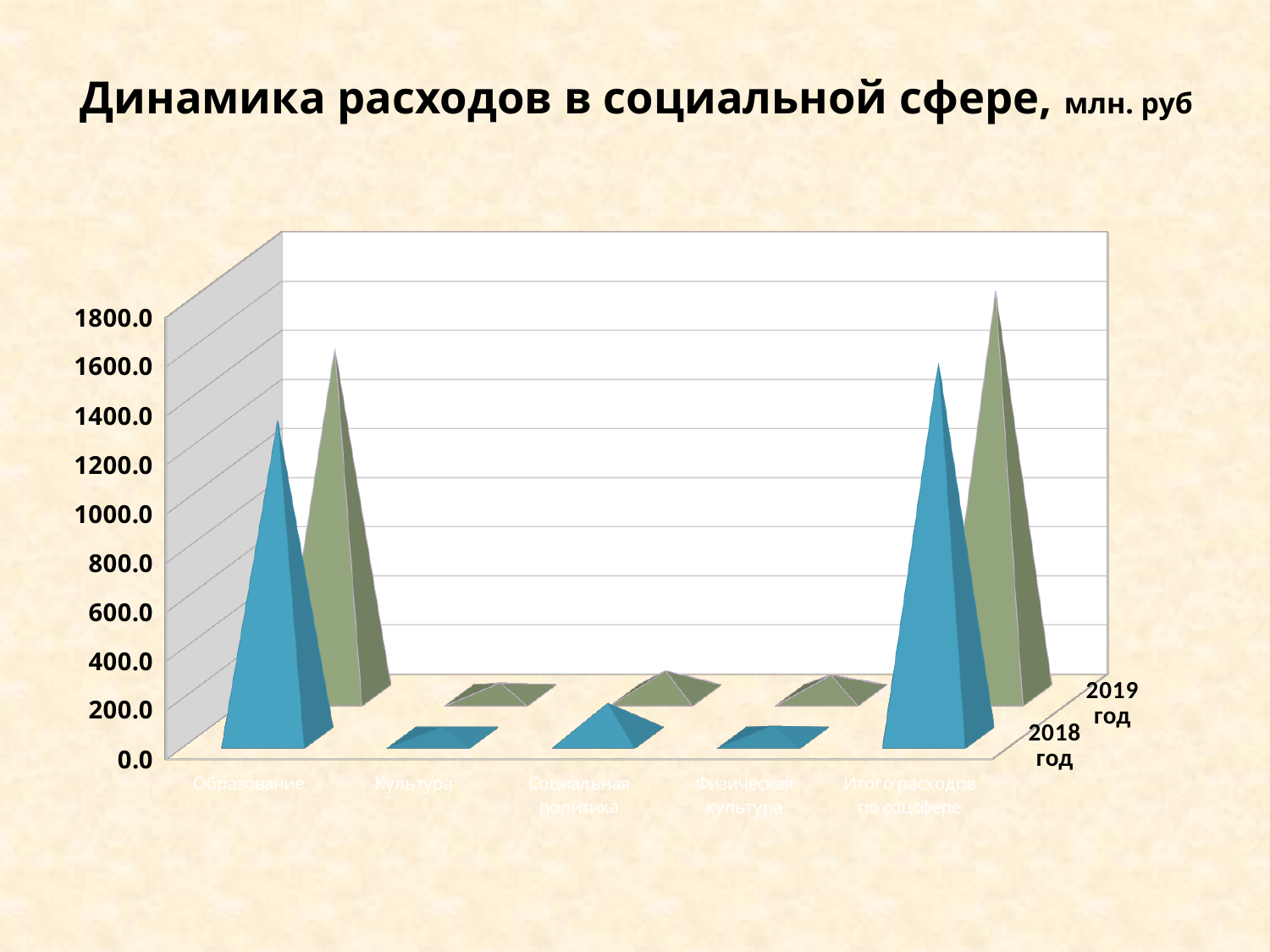
What is the title of the chart on the slide? Динамика расходов в социальной сфере, млн. руб Is the value for Образование in 2018 год greater or less than 1000.0? greater Which category has the highest value for 2019 год? Итого расходов по соцсфере Is the value for Итого расходов по соцсфере in 2018 год greater or less than 1200.0? greater What kind of chart is shown on the slide? bar chart Is the value for Физическая культура in 2018 год greater or less than 400.0? less Which years are compared in the chart? 2018 год and 2019 год For 2018 год, which is larger: Образование or Социальная политика? Образование Which category has the highest value for 2018 год? Итого расходов по соцсфере How many years (series) are plotted in the chart? 2 How many categories are shown along the x axis of the chart? 5